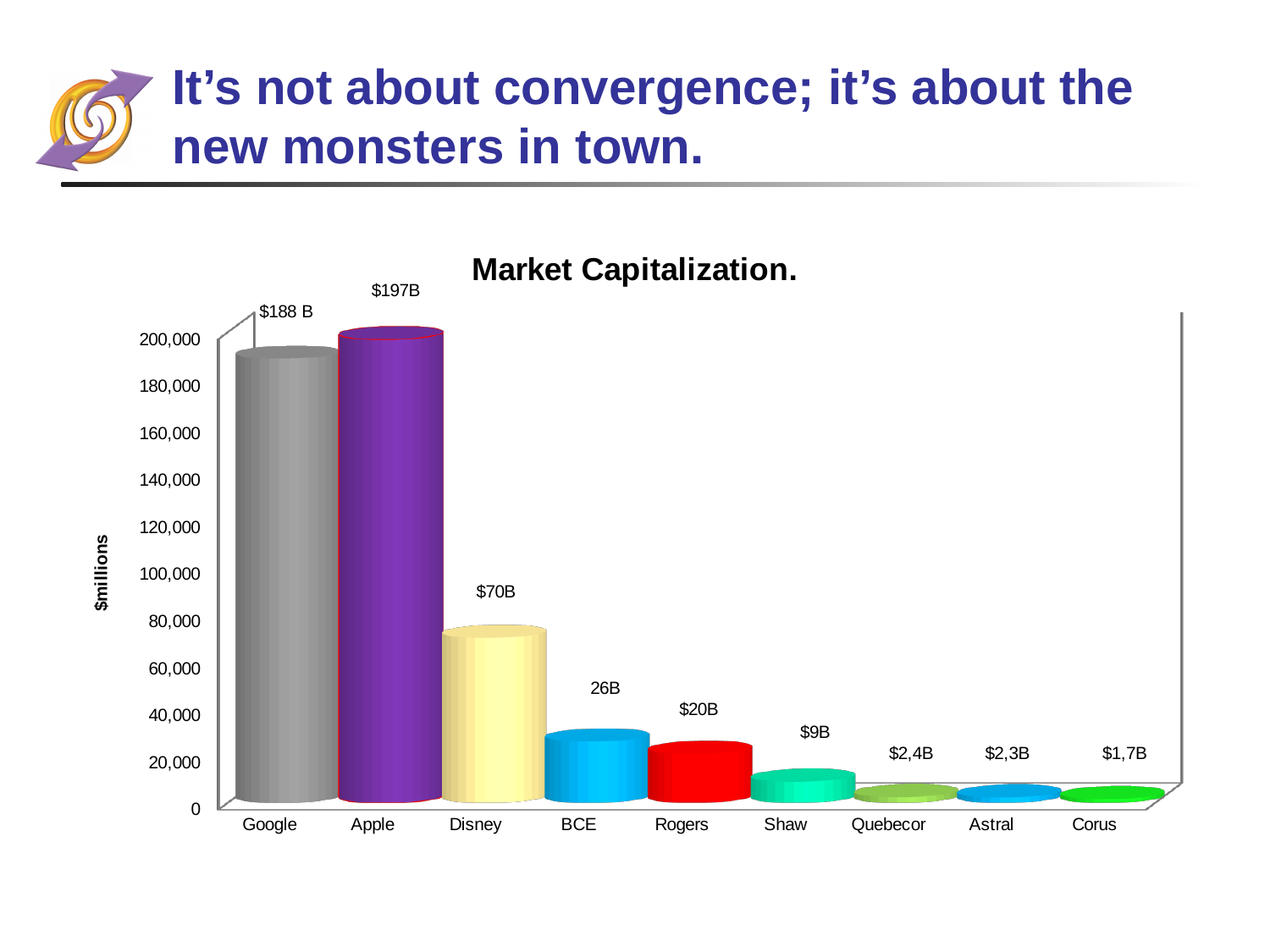
Which company has the highest market capitalization on the chart? Apple Is the value for Disney greater or less than 80,000 on the axis? less How many companies are shown on the chart? 9 What is the label on the vertical axis of the chart? $millions How much larger is Apple's labelled value than Google's? $9B What kind of chart is shown on the slide? Bar chart Which is larger, the value for BCE or the value for Rogers? BCE Which company has the lowest market capitalization on the chart? Corus What is the market capitalization value shown for Apple? $197B What value is labelled on the Google bar? $188 B What value is labelled for Quebecor? $2,4B What is the value shown for Disney? $70B